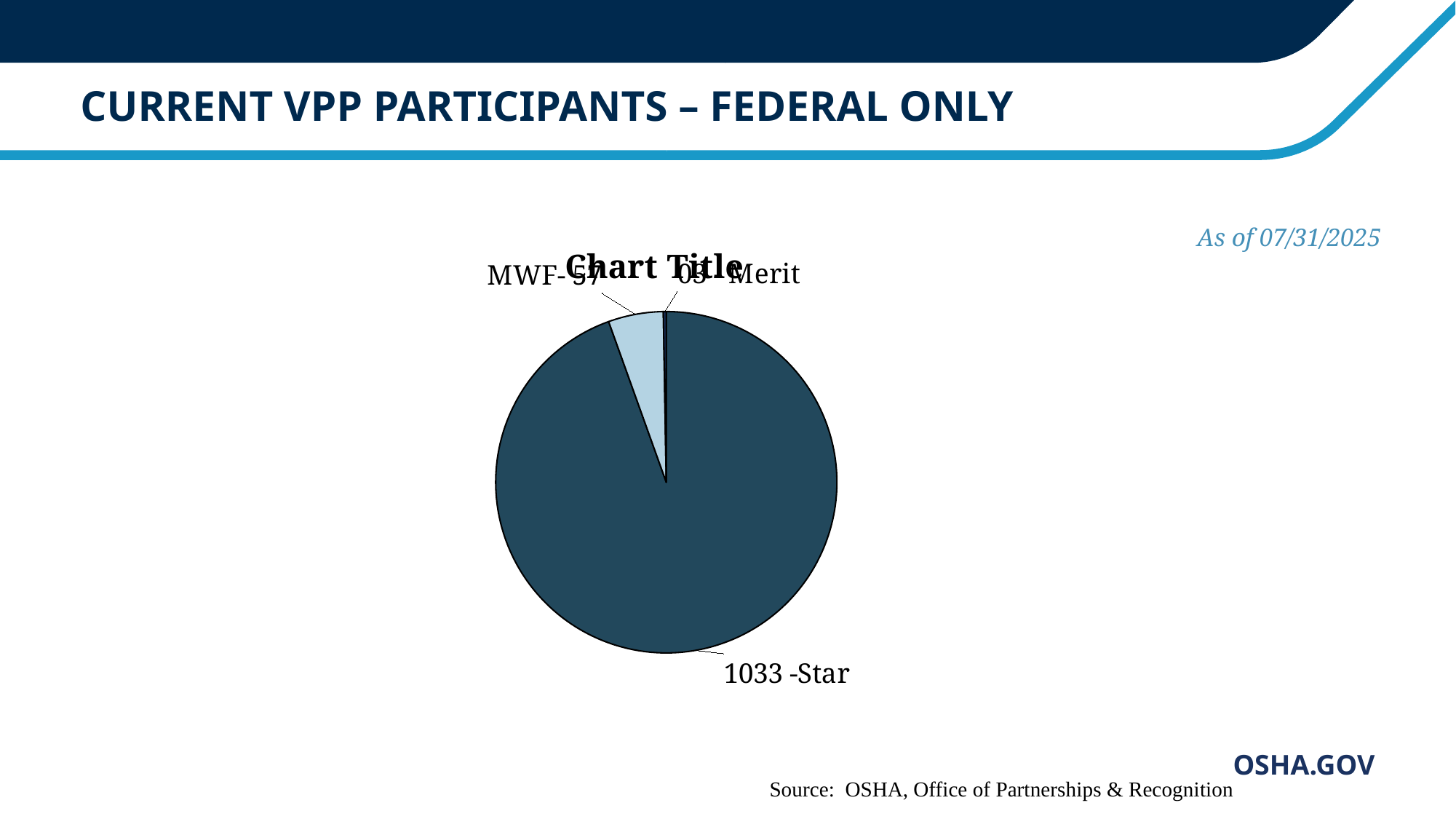
What kind of chart is shown on the slide? pie chart Which slice is larger, MWF or Merit? MWF How many slices does the pie chart have? 3 Which slice is larger, Star or MWF? Star Which slice of the pie chart is coloured light blue? MWF What is the value shown for the Star slice? 1033 Which category has the largest slice of the pie chart? Star What is the title printed above the pie chart? Chart Title Is the value for Star greater or less than 1000? greater Which category has the smallest slice of the pie chart? Merit